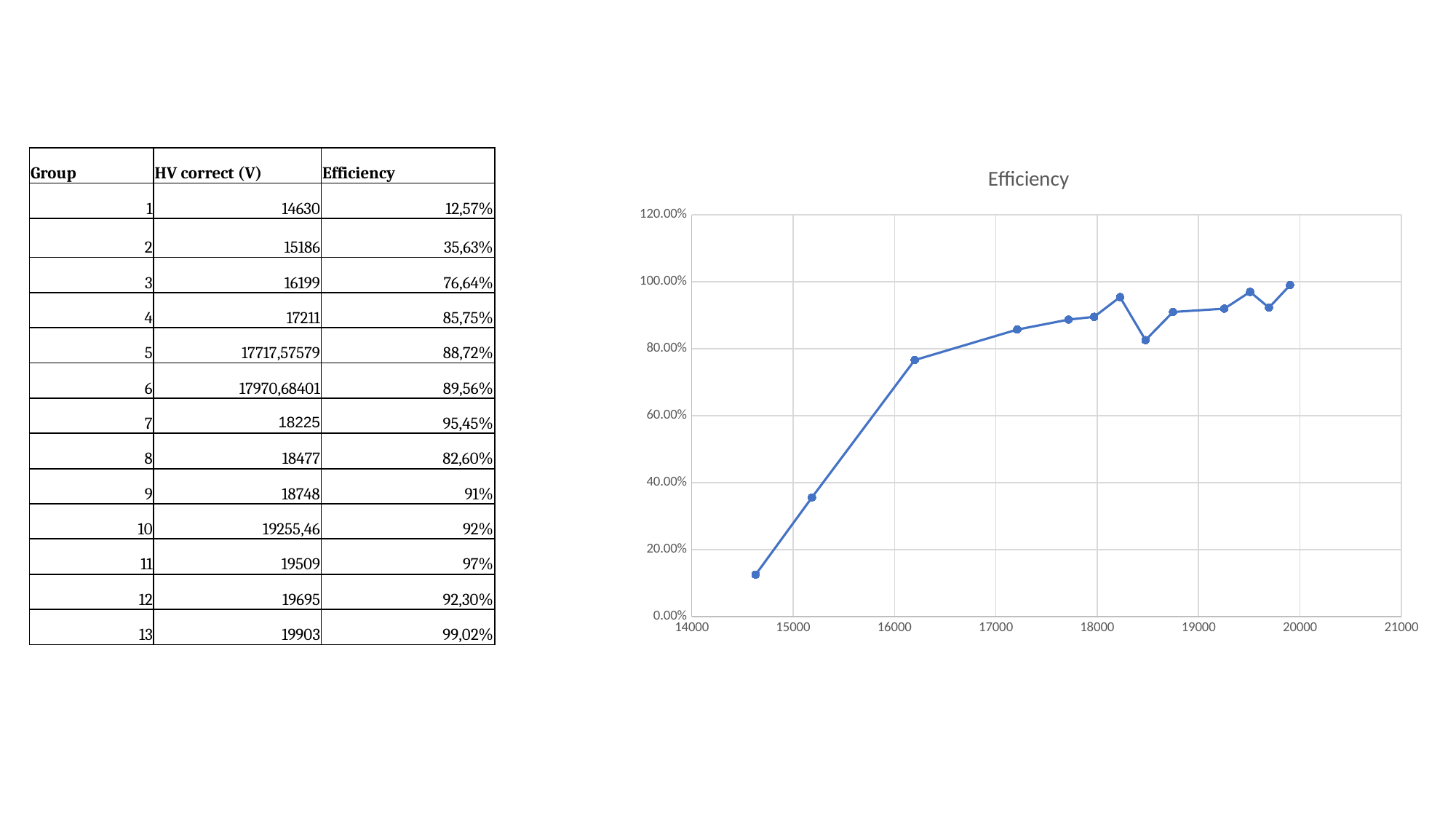
Is the efficiency at HV 16199 V greater or less than 60%? greater What kind of chart is shown on the slide? line chart How many data points are plotted on the chart? 13 Which has the higher efficiency, HV 18225 V or HV 18477 V? 18225 What is the efficiency at HV 18477 V? 82,60% Is the efficiency at the lowest HV value (14630 V) greater or less than 20%? less What is the title of the chart? Efficiency What is the efficiency at HV 18225 V? 95,45% Which HV value has the highest efficiency? 19903 Do the efficiency values generally rise or fall as HV increases along the x axis? rise Which HV value has the lowest efficiency? 14630 What is the difference between the highest efficiency (99,02%) and the lowest efficiency (12,57%)? 86,45%